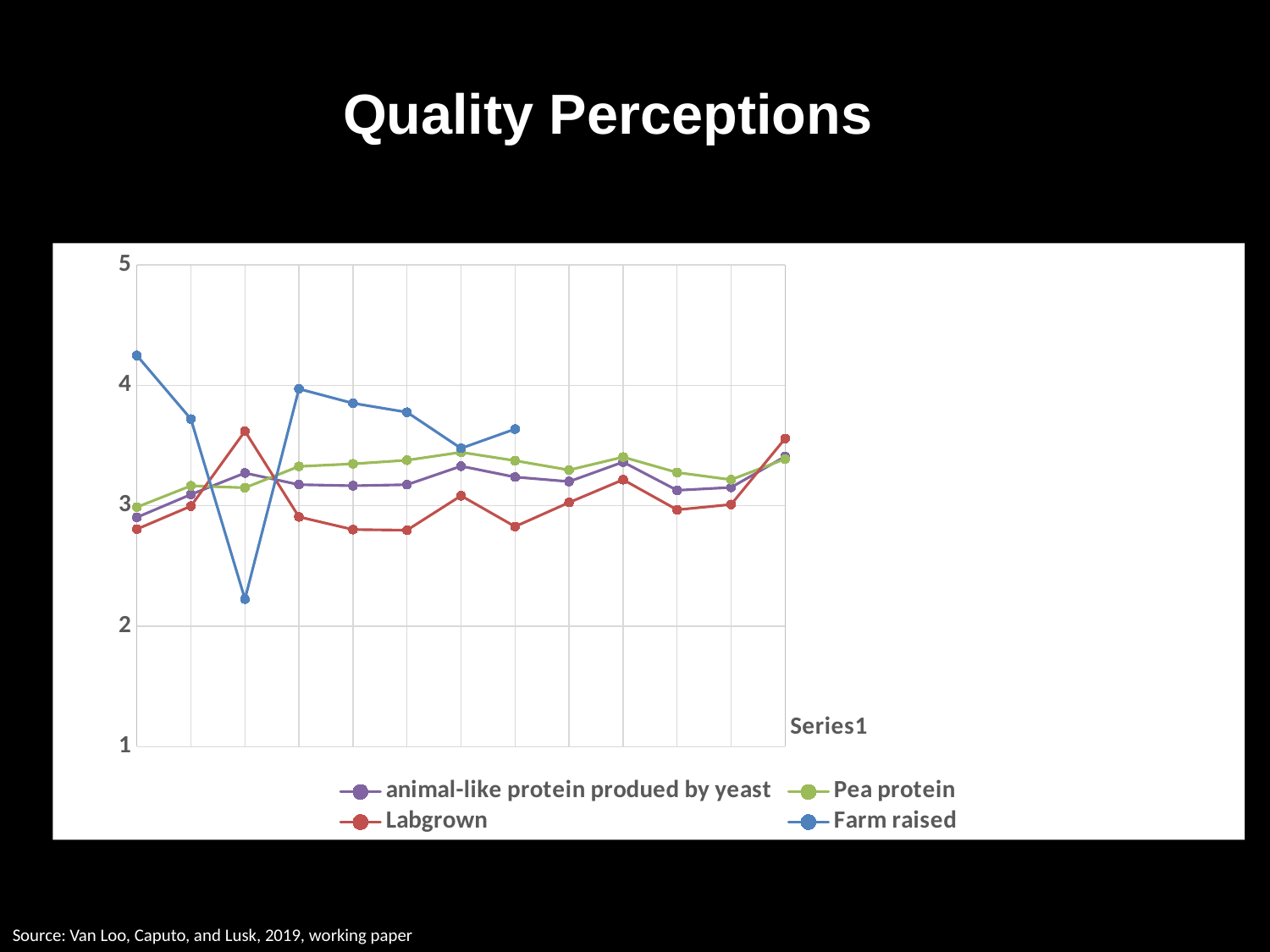
Which series has the lowest value at the third point from the left? Farm raised What kind of chart is shown on the slide? line chart Which series has the highest value at the leftmost point? Farm raised Does the Farm raised series rise or fall between its first and second points? fall Is the third point from the left of the Labgrown series greater or less than 3? greater At the leftmost point, which is higher: Pea protein or Labgrown? Pea protein Which series is drawn in blue according to the legend? Farm raised Is the third point from the left of the Farm raised series greater or less than 3? less Is the leftmost value of the Farm raised series greater or less than 4? greater How many data points does the Farm raised series have? 8 How many series does the legend list? 4 What is the title of the chart on the slide? Quality Perceptions